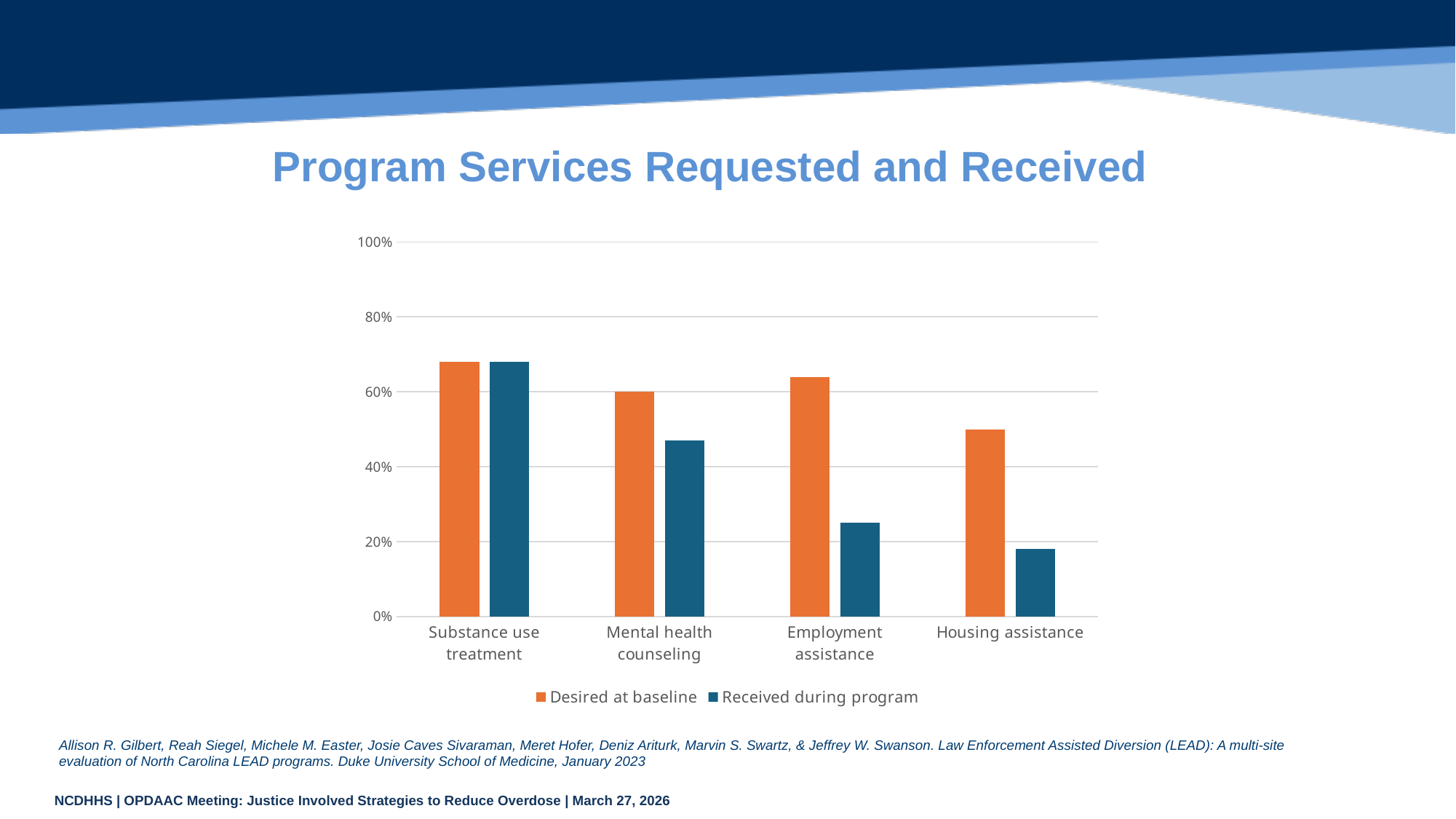
For Employment assistance, which is larger: Desired at baseline or Received during program? Desired at baseline How many service categories are shown on the x axis? 4 What is the value for Mental health counseling in the Desired at baseline series? 60% Which category has the highest value in the Received during program series? Substance use treatment Is the Received during program value for Housing assistance greater or less than 20%? less What is the title of the chart? Program Services Requested and Received How many series does the legend list? 2 Which category has the lowest value in the Received during program series? Housing assistance Is the Received during program value for Employment assistance greater or less than 40%? less Which category has the lowest value in the Desired at baseline series? Housing assistance Is the Desired at baseline value for Substance use treatment greater or less than 60%? greater What kind of chart is shown on the slide? bar chart